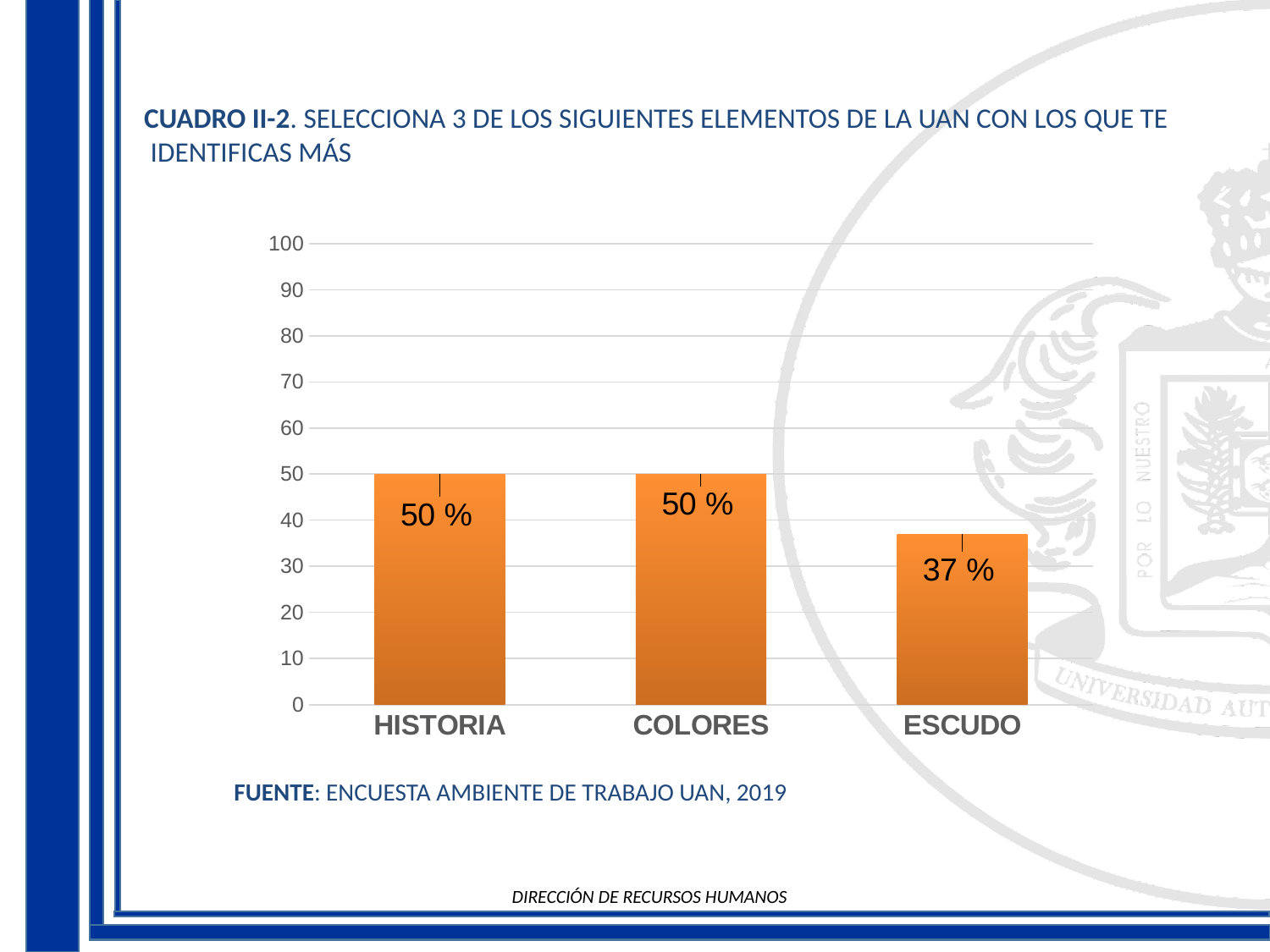
Is the value for ESCUDO greater or less than 40? less What is the value for ESCUDO? 37 % What is the value for HISTORIA? 50 % How many categories are shown on the chart? 3 What is the value for COLORES? 50 % Which is larger, the value for COLORES or the value for ESCUDO? COLORES Which category has the lowest value? ESCUDO What is the difference between the values for HISTORIA and ESCUDO? 13 % What kind of chart is shown on the slide? bar chart What is the highest value shown on the vertical axis? 100 What source is cited below the chart? ENCUESTA AMBIENTE DE TRABAJO UAN, 2019